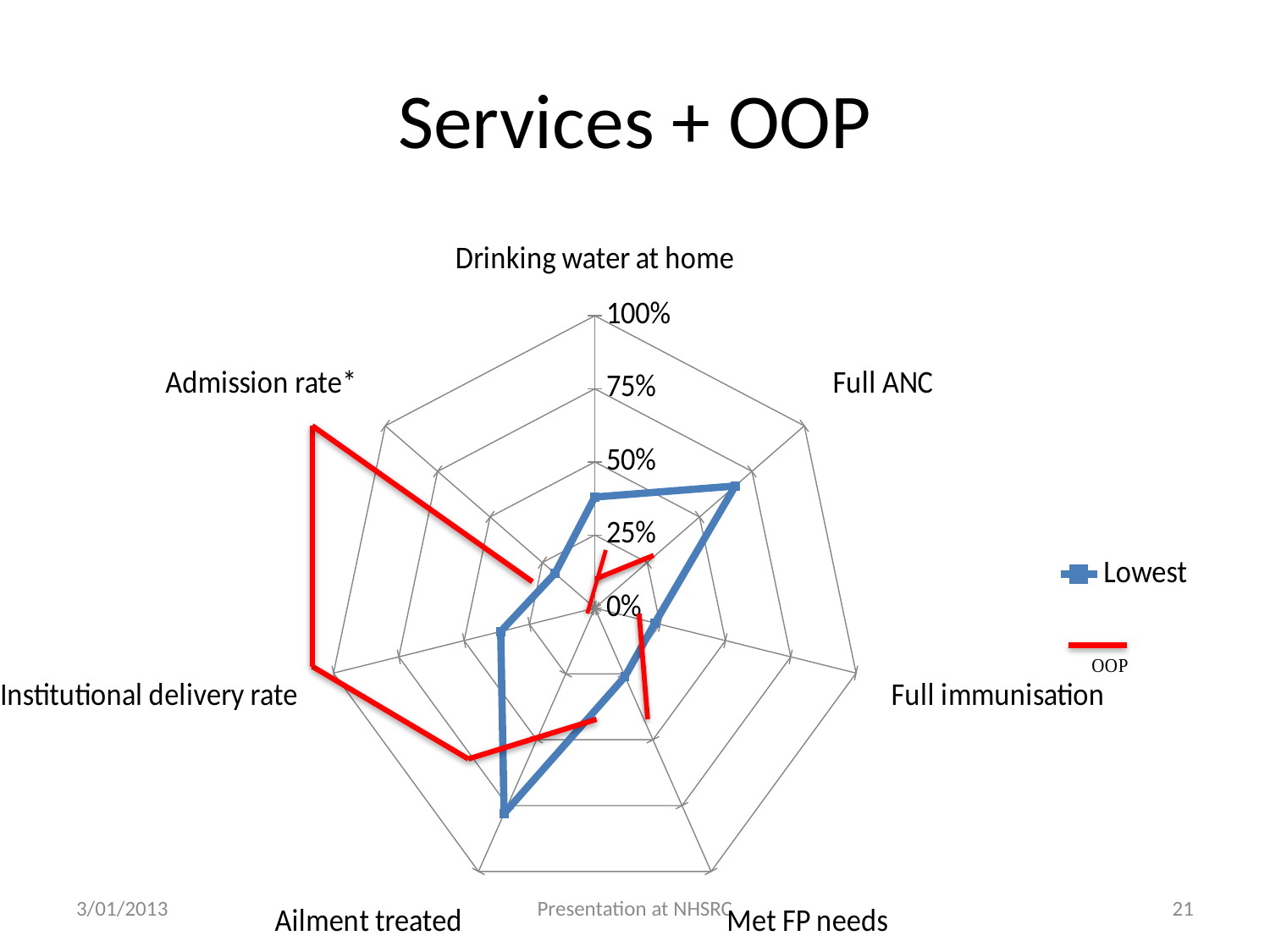
Is the Lowest value for Drinking water at home greater or less than 50%? less Is the Lowest value for Full ANC greater or less than 50%? greater Is the Lowest value for Institutional delivery rate greater or less than 50%? less What are the two series named in the legend? Lowest and OOP How many categories (axes) does the radar chart have? 7 For the Lowest series, which is larger: Ailment treated or Admission rate*? Ailment treated How many series does the legend list? 2 What kind of chart is shown on the slide? Radar chart For the Lowest series, which is larger: Full ANC or Drinking water at home? Full ANC What is the title of the chart slide? Services + OOP